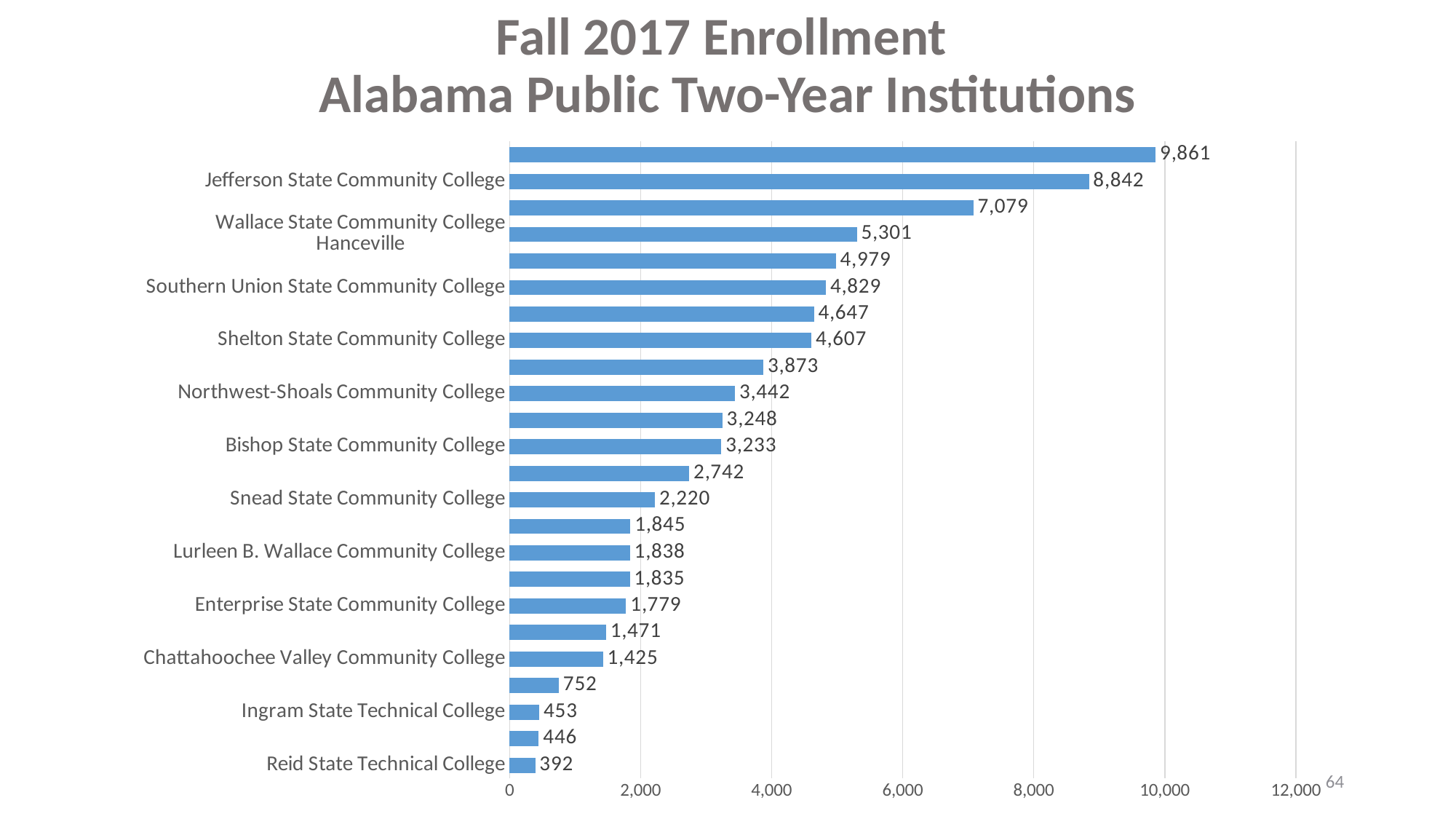
How many bars are plotted on the chart? 24 What is the Fall 2017 enrollment for Jefferson State Community College? 8,842 What is the largest enrollment value shown on the chart? 9,861 What is the difference in enrollment between Jefferson State Community College and Southern Union State Community College? 4,013 What is the enrollment for Shelton State Community College? 4,607 Which labeled institution has the lowest enrollment on the chart? Reid State Technical College What is the enrollment for Snead State Community College? 2,220 What is the enrollment value shown for Wallace State Community College Hanceville? 5,301 Is the enrollment for Chattahoochee Valley Community College greater or less than 2,000? less Which has a higher enrollment, Northwest-Shoals Community College or Bishop State Community College? Northwest-Shoals Community College What is the enrollment for Ingram State Technical College? 453 What type of chart is shown on the slide? Bar chart